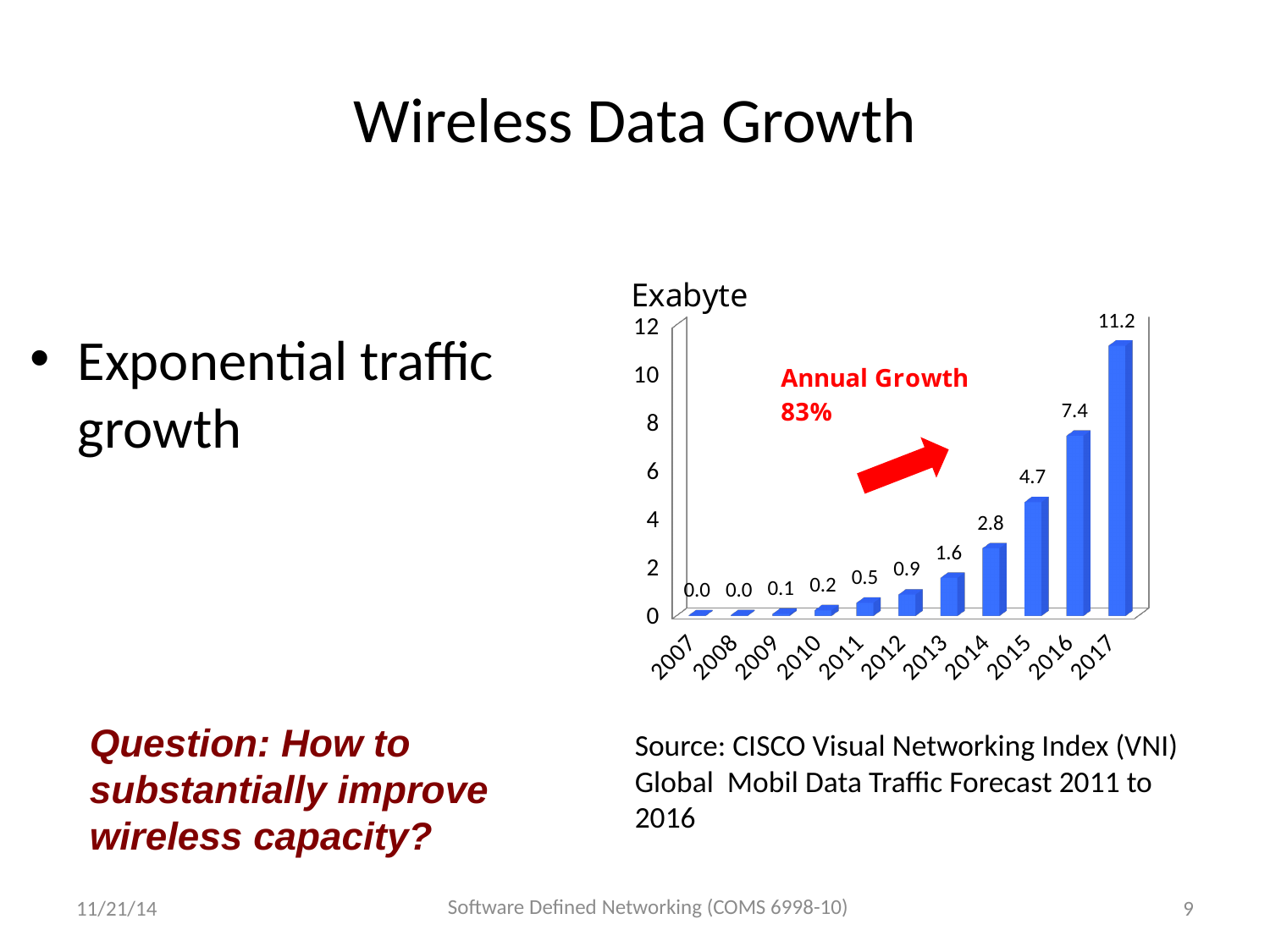
Do the values rise or fall from 2007 to 2017? rise What is the value for 2017? 11.2 Which year has the highest value? 2017 What kind of chart is shown? bar chart What is the value for 2011? 0.5 Is the value for 2016 greater or less than 6? greater How many years are shown on the x axis? 11 What is the difference between the values for 2015 and 2014? 1.9 Which is larger, the value for 2013 or the value for 2012? 2013 What is the value for 2014? 2.8 What is the difference between the values for 2017 and 2016? 3.8 What annual growth rate is annotated on the chart? 83%